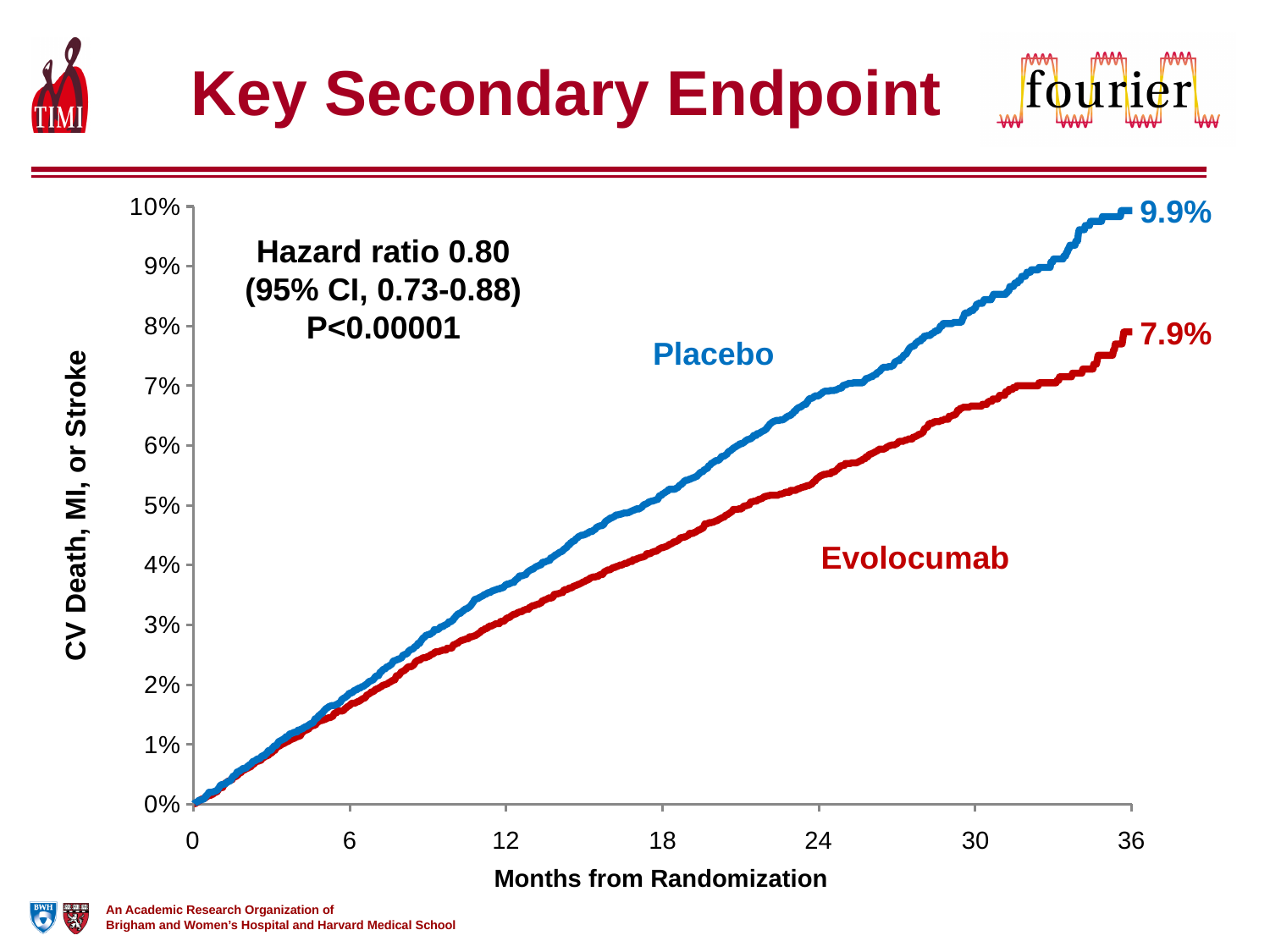
Is the value for Evolocumab at 24 months greater or less than 6%? less Which curve ends higher at 36 months, Placebo or Evolocumab? Placebo What kind of chart is shown on the slide? Line chart What is the difference between the final Placebo and Evolocumab values? 2.0% What is the final value shown for the Evolocumab curve at 36 months? 7.9% Is the value for Placebo at 24 months greater or less than 6%? greater What hazard ratio is reported on the chart? 0.80 Do the curves rise or fall as months from randomization increase? Rise What is the final value shown for the Placebo curve at 36 months? 9.9% Which treatment group has the lower event rate at the end of follow-up? Evolocumab What is the label of the y axis? CV Death, MI, or Stroke How many treatment groups are plotted on the chart? 2